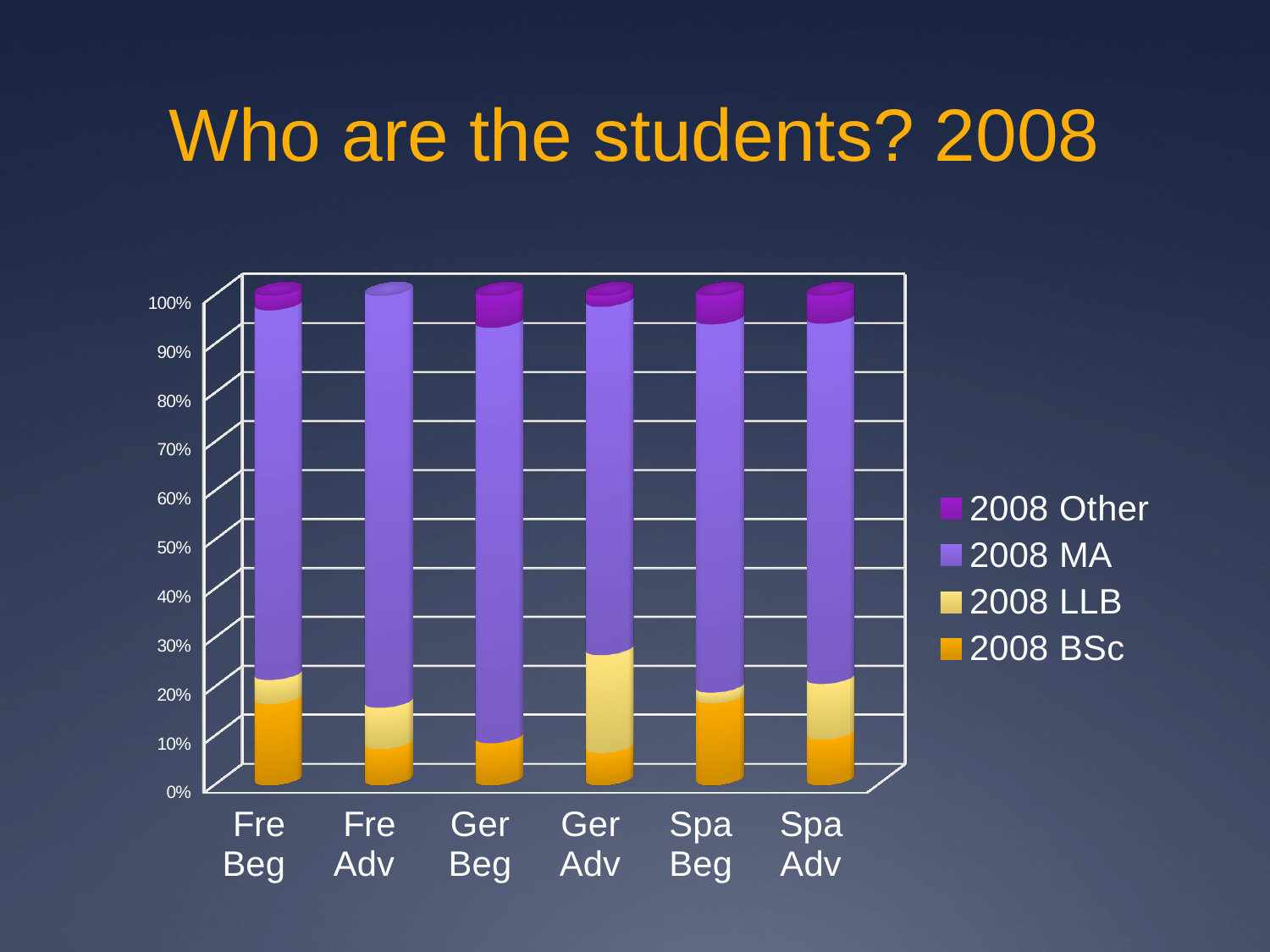
What is the title of the slide? Who are the students? 2008 Which series is shown in purple at the top of each bar? 2008 Other What is the total of the Fre Beg stacked bar? 100% How many series does the legend list? 4 What kind of chart is shown on the slide? Stacked bar chart Which category has the smallest 2008 Other share? Fre Adv Which is larger, the 2008 LLB share for Ger Adv or for Fre Beg? Ger Adv Is the 2008 MA value for Ger Beg greater or less than 50%? greater Which category has the largest 2008 LLB share? Ger Adv Which category has the smallest 2008 LLB share? Ger Beg Is the 2008 BSc value for Fre Beg greater or less than 10%? greater How many categories are shown on the x axis of the chart? 6